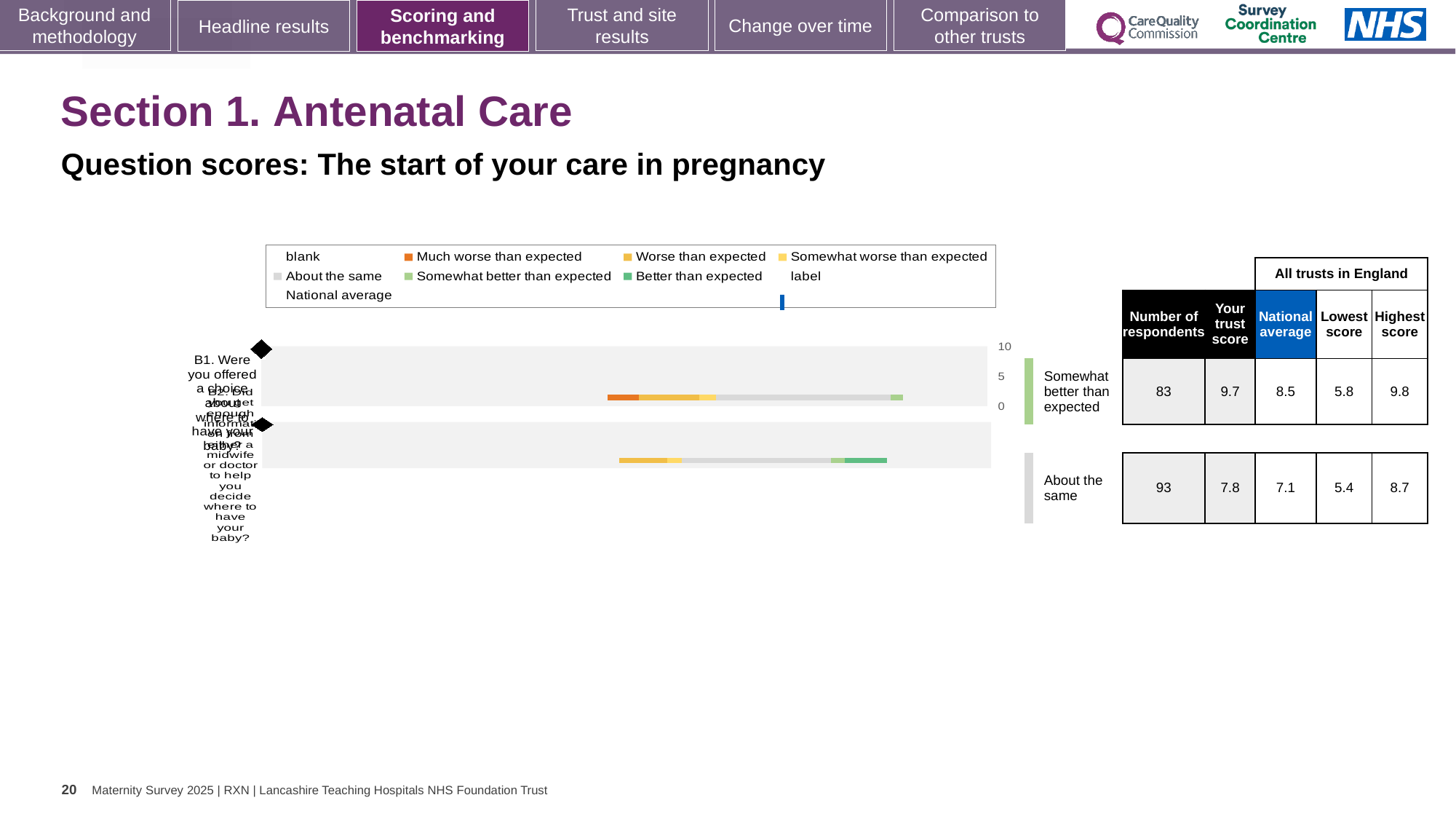
How many questions are plotted in the chart? 2 What is the difference between the highest and lowest scores for question B2? 3.3 Which question has the larger number of respondents? B2 By how much does the trust score for question B1 exceed the national average for that question? 1.2 What type of chart is used to show the question scores on this slide? bar chart What is the lowest score across all trusts in England for question B1? 5.8 What is the highest score across all trusts in England for question B2? 8.7 How many respondents answered question B1? 83 What is the national average for question B2 (Did you get enough information from either a midwife or doctor to help you decide where to have your baby?)? 7.1 Which question has the higher 'Your trust score', B1 or B2? B1 What benchmark category is shown for question B1? Somewhat better than expected What is the 'Your trust score' for question B1 (Were you offered a choice about where to have your baby?)? 9.7